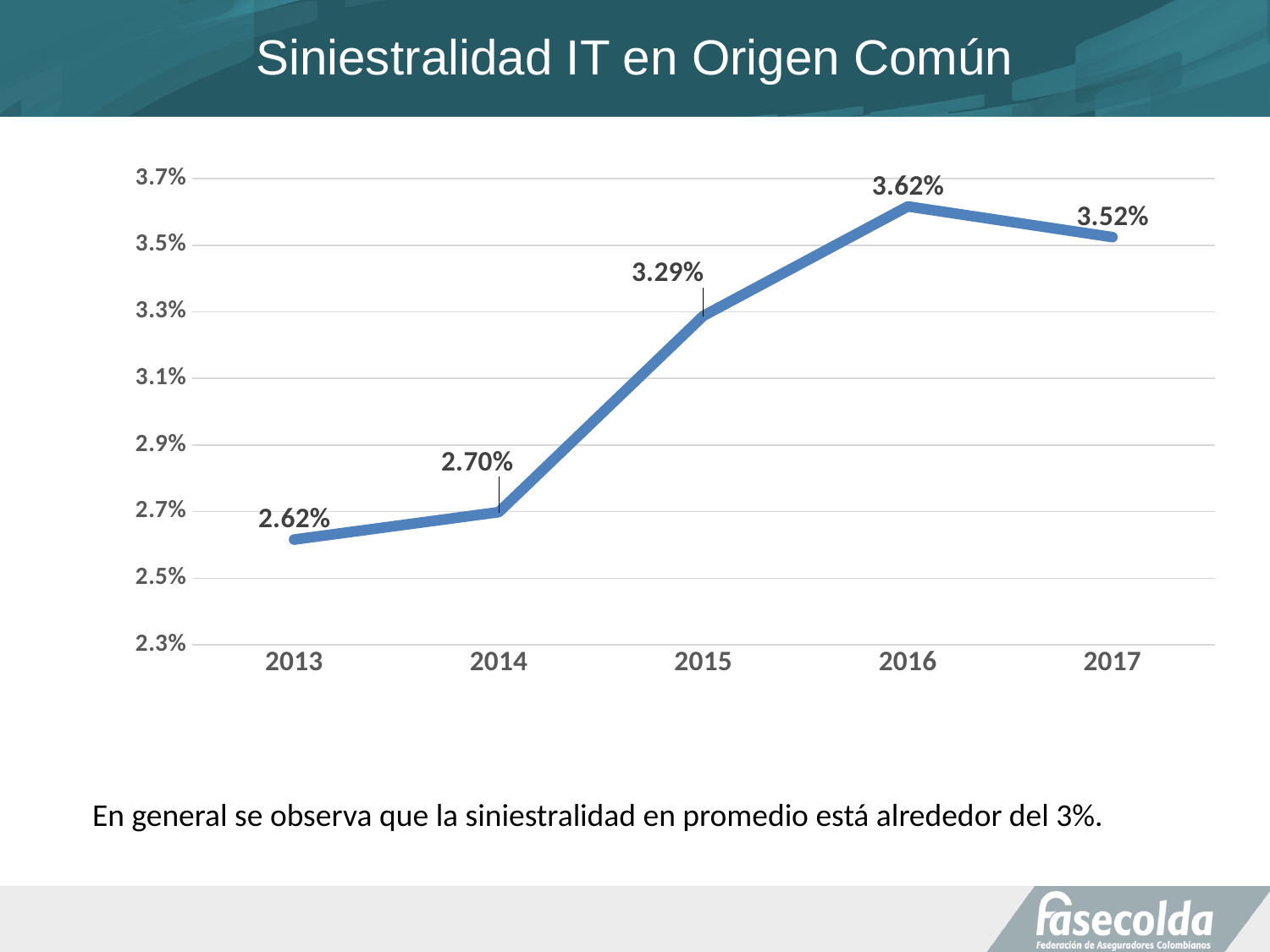
What is the difference between the values for 2016 and 2015? 0.33% Is the value for 2015 greater or less than 3.1%? greater Which is larger, the value for 2016 or the value for 2017? 2016 What is the title of the slide? Siniestralidad IT en Origen Común What is the value for 2013? 2.62% What is the value for 2017? 3.52% What is the value for 2015? 3.29% What is the difference between the values for 2014 and 2013? 0.08% Which year has the lowest value? 2013 What kind of chart is shown on the slide? line chart How many years are plotted on the chart? 5 Which year has the highest value? 2016